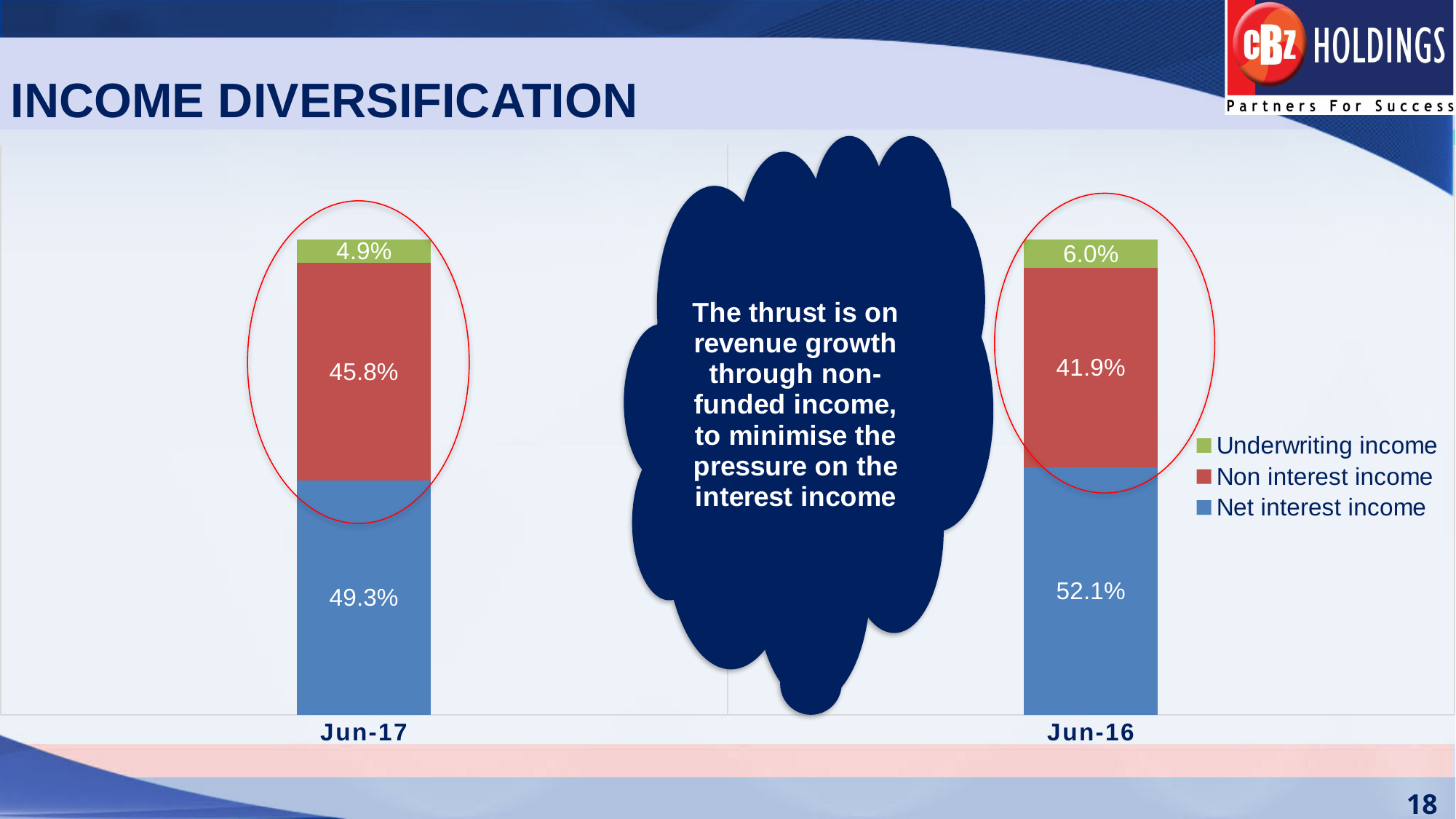
What kind of chart is shown on the slide? Stacked bar chart Which colour represents Non interest income in the legend? Red Which period has the higher Non interest income share, Jun-17 or Jun-16? Jun-17 What is the difference in Net interest income share between Jun-16 and Jun-17? 2.8% How many series does the legend list? 3 What is the Non interest income share for Jun-16? 41.9% What is the Net interest income share for Jun-17? 49.3% What is the Underwriting income share for Jun-16? 6.0% What is the Net interest income share for Jun-16? 52.1% How many periods are shown on the x axis? 2 What is the Underwriting income share for Jun-17? 4.9% What is the difference in Underwriting income share between Jun-16 and Jun-17? 1.1%